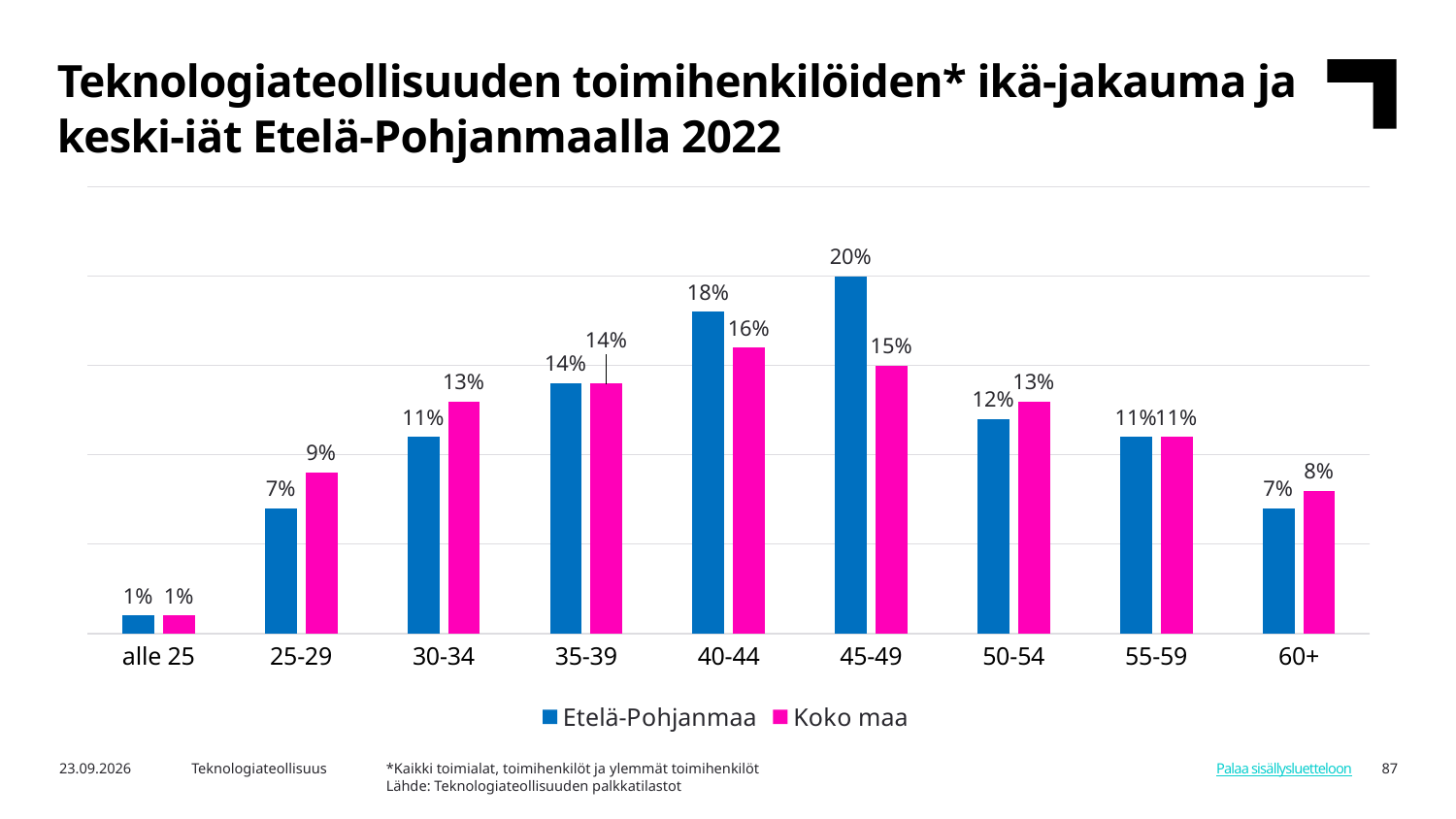
Which age group has the lowest value for Koko maa? alle 25 Which age group has the highest value for Etelä-Pohjanmaa? 45-49 How many age groups are shown on the x axis? 9 What is the value for Koko maa in the 30-34 age group? 13% What is the value for Etelä-Pohjanmaa in the 45-49 age group? 20% Which colour represents Koko maa in the legend? Pink (magenta) What is the value for Etelä-Pohjanmaa in the 25-29 age group? 7% Which is larger in the 25-29 age group, Etelä-Pohjanmaa or Koko maa? Koko maa What is the difference between Etelä-Pohjanmaa and Koko maa in the 45-49 age group? 5 percentage points What kind of chart is shown on the slide? Bar chart How many series does the legend list? 2 Do the Etelä-Pohjanmaa values rise or fall from the 45-49 age group to the 60+ age group? Fall